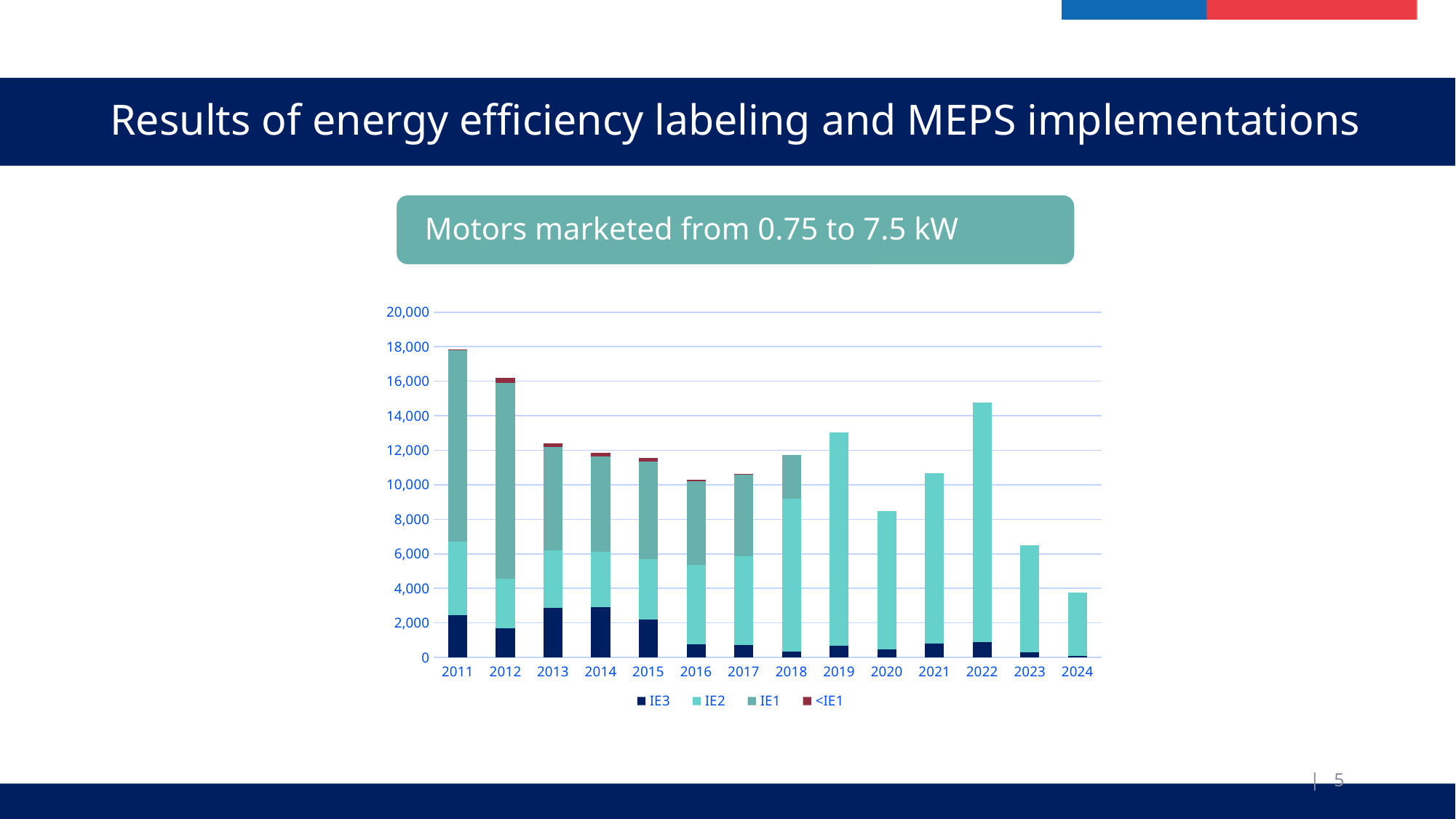
Does the IE1 segment of the bars grow or shrink from 2011 to 2018? shrink Is the total bar height for 2020 greater or less than 10,000? less Is the total bar height for 2024 greater or less than 6,000? less What is the title shown in the box above the chart? Motors marketed from 0.75 to 7.5 kW Is the total bar height for 2022 greater or less than 14,000? greater Which year has the shortest stacked bar in the chart? 2024 What kind of chart is shown on the slide? Stacked bar chart Which year has the tallest stacked bar in the chart? 2011 How many series does the chart legend list? 4 Which year has the taller stacked bar, 2019 or 2020? 2019 How many years are shown on the x axis of the chart? 14